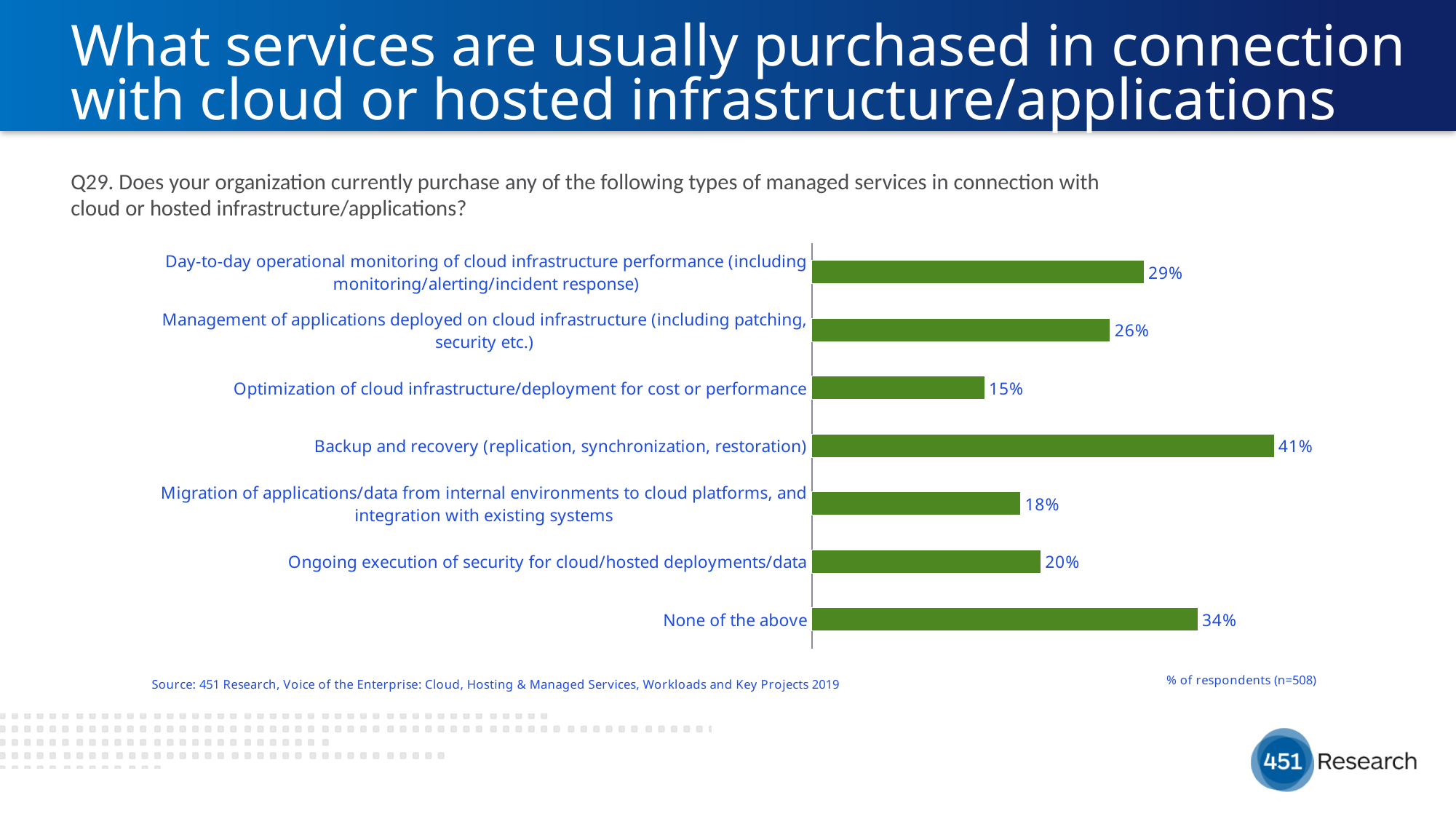
What percentage of respondents purchase backup and recovery (replication, synchronization, restoration) services? 41% What is the sample size (n) noted on the slide for the chart? n=508 Which service category has the highest percentage of respondents? Backup and recovery (replication, synchronization, restoration) What is the difference in percentage points between day-to-day operational monitoring of cloud infrastructure performance and management of applications deployed on cloud infrastructure? 3 percentage points What type of chart is shown on the slide? Bar chart Which service category has the lowest percentage of respondents? Optimization of cloud infrastructure/deployment for cost or performance What is the value for ongoing execution of security for cloud/hosted deployments/data? 20% What percentage of respondents purchase optimization of cloud infrastructure/deployment for cost or performance? 15% What is the value for 'None of the above'? 34% How many categories are shown in the chart? 7 Which has a higher value: migration of applications/data from internal environments to cloud platforms, or ongoing execution of security for cloud/hosted deployments/data? Ongoing execution of security for cloud/hosted deployments/data What is the difference in percentage points between 'None of the above' and backup and recovery? 7 percentage points